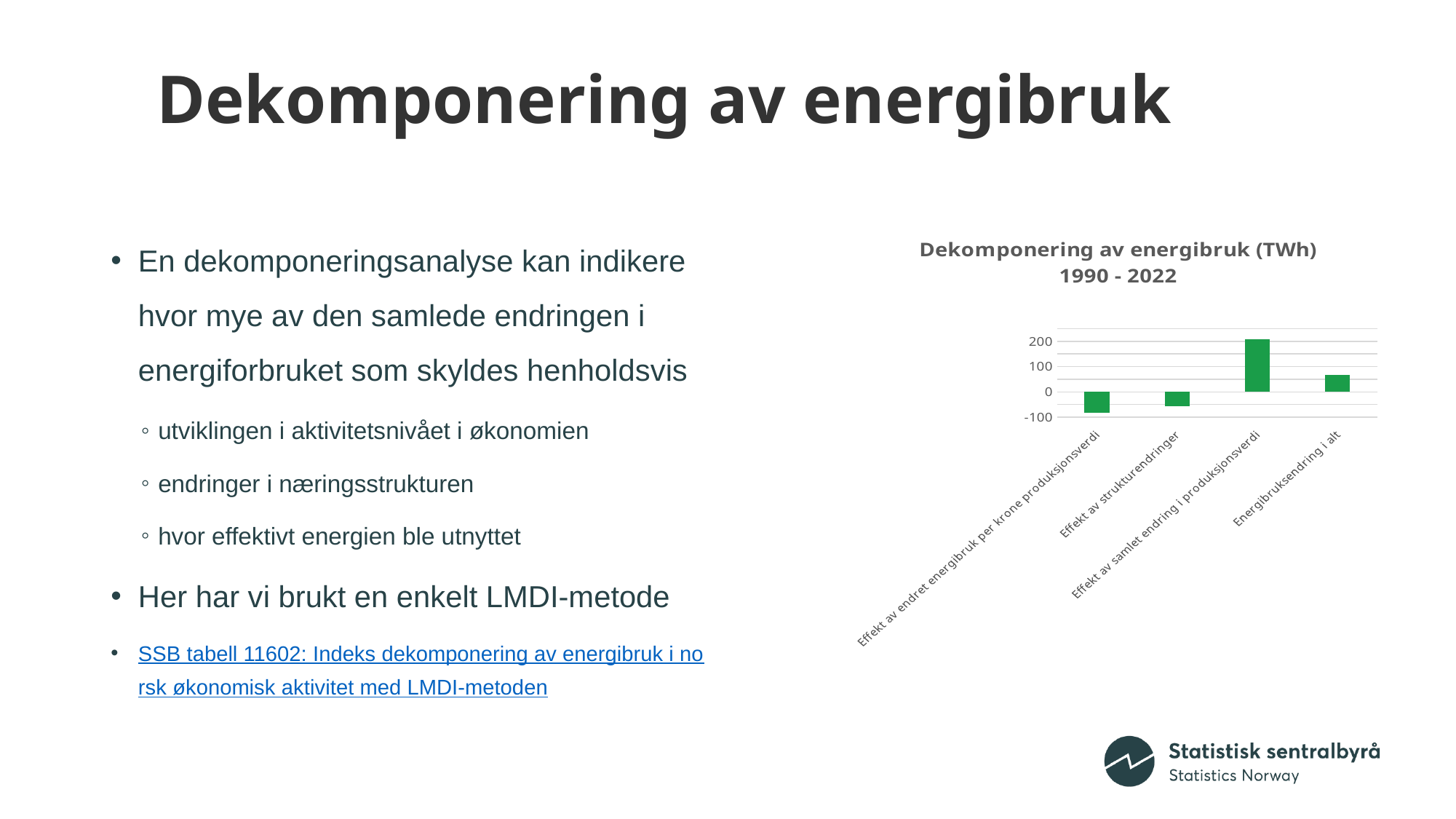
Which is larger: the value for 'Energibruksendring i alt' or the value for 'Effekt av strukturendringer'? Energibruksendring i alt What is the title of the chart? Dekomponering av energibruk (TWh) 1990 - 2022 Is the value for 'Effekt av strukturendringer' greater or less than 0? less Which category has the highest value in the chart? Effekt av samlet endring i produksjonsverdi What unit is given in the chart title? TWh Is the value for 'Energibruksendring i alt' greater or less than 100? less Is the value for 'Effekt av endret energibruk per krone produksjonsverdi' greater or less than -100? greater Which category has the lowest value in the chart? Effekt av endret energibruk per krone produksjonsverdi Which is larger: the value for 'Effekt av samlet endring i produksjonsverdi' or the value for 'Energibruksendring i alt'? Effekt av samlet endring i produksjonsverdi How many categories (bars) does the chart show? 4 What kind of chart is shown on the slide? bar chart